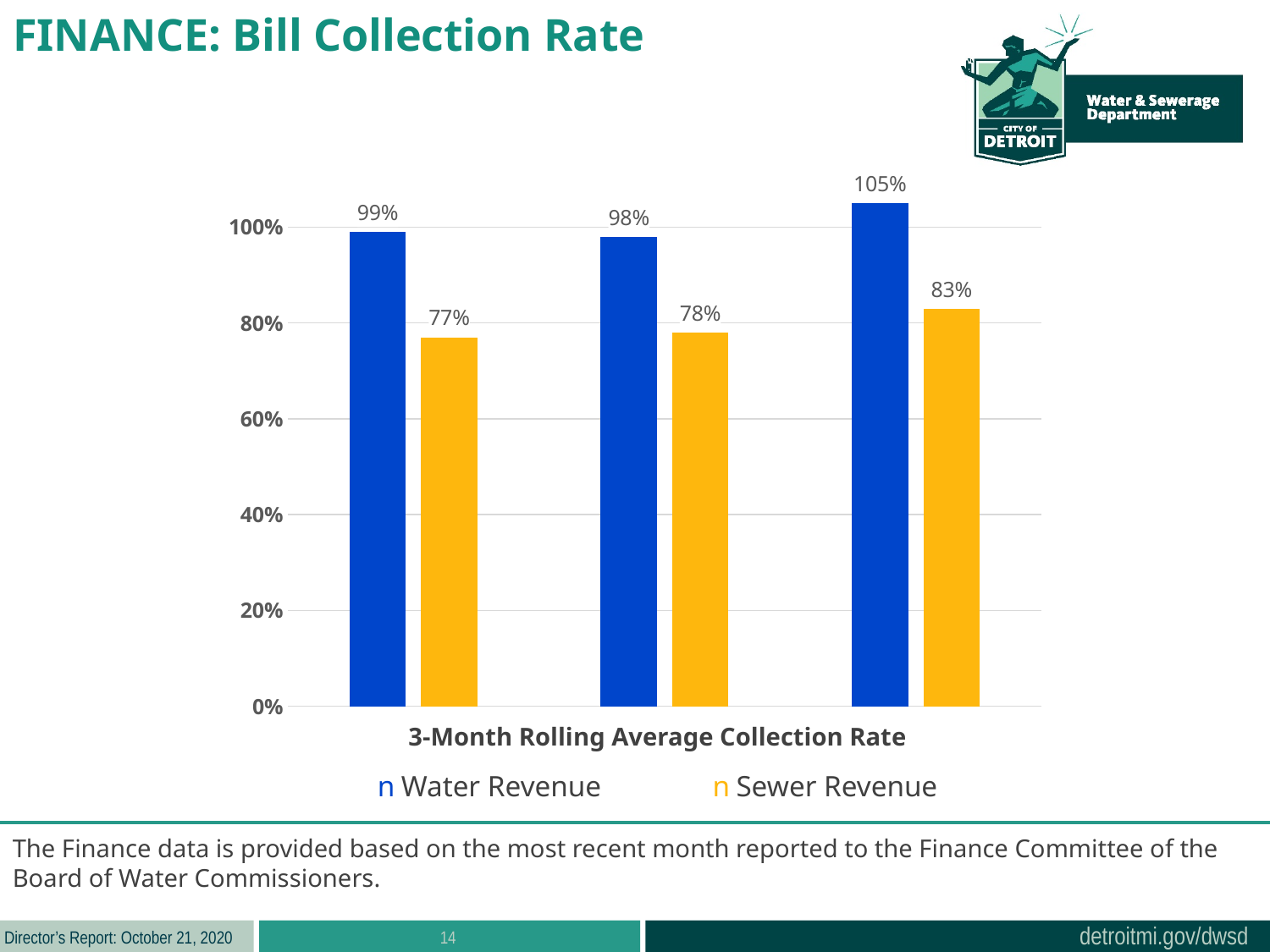
What is the Sewer Revenue value in the rightmost group of bars? 83% How many groups of bars are plotted in the chart? 3 What is the Water Revenue value in the leftmost group of bars? 99% Which group of bars has the lowest Sewer Revenue value, and what is it? The leftmost group, 77% Which group of bars has the highest Water Revenue value, and what is it? The rightmost group, 105% What is the title shown below the x axis of the chart? 3-Month Rolling Average Collection Rate In the rightmost group, what is the difference between the Water Revenue and Sewer Revenue values? 22 percentage points Do the Sewer Revenue values rise or fall from the leftmost group to the rightmost group? Rise What is the Sewer Revenue value in the middle group of bars? 78% What kind of chart is shown on the slide? Bar chart In the middle group, which is larger: Water Revenue or Sewer Revenue? Water Revenue How many series does the legend list? 2